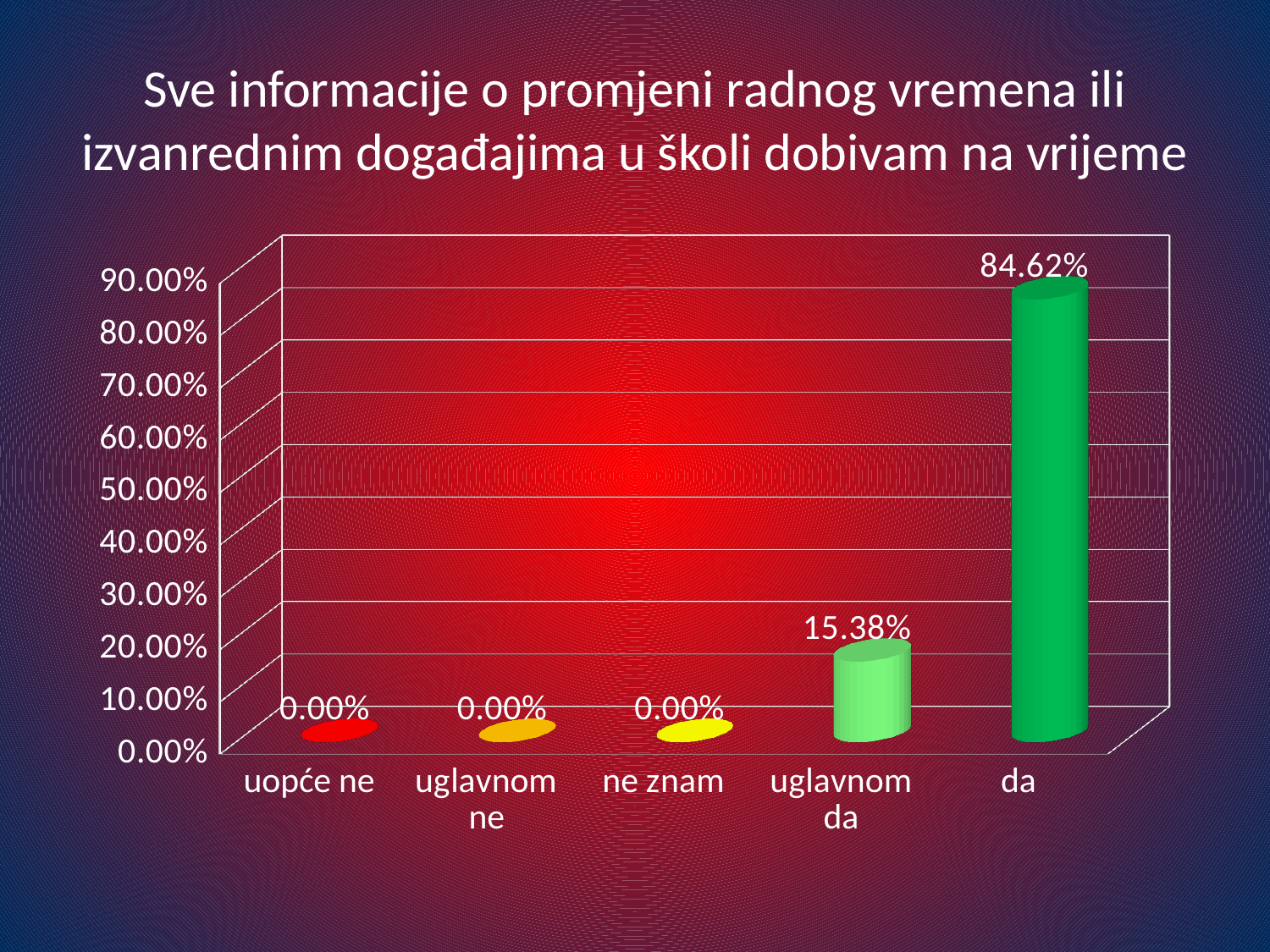
Which category has the highest value? da What colour is the bar for "da"? green How many categories have a value of 0.00%? 3 What is the value for "da"? 84.62% What is the value for "uglavnom da"? 15.38% What kind of chart is shown on the slide? bar chart How many categories are shown on the x axis? 5 Is the value for "da" greater or less than 80.00%? greater Is the value for "uglavnom da" greater or less than 20.00%? less What is the difference between the values for "da" and "uglavnom da"? 69.24% What is the value for "ne znam"? 0.00% Which is larger, the value for "uglavnom da" or the value for "uglavnom ne"? uglavnom da